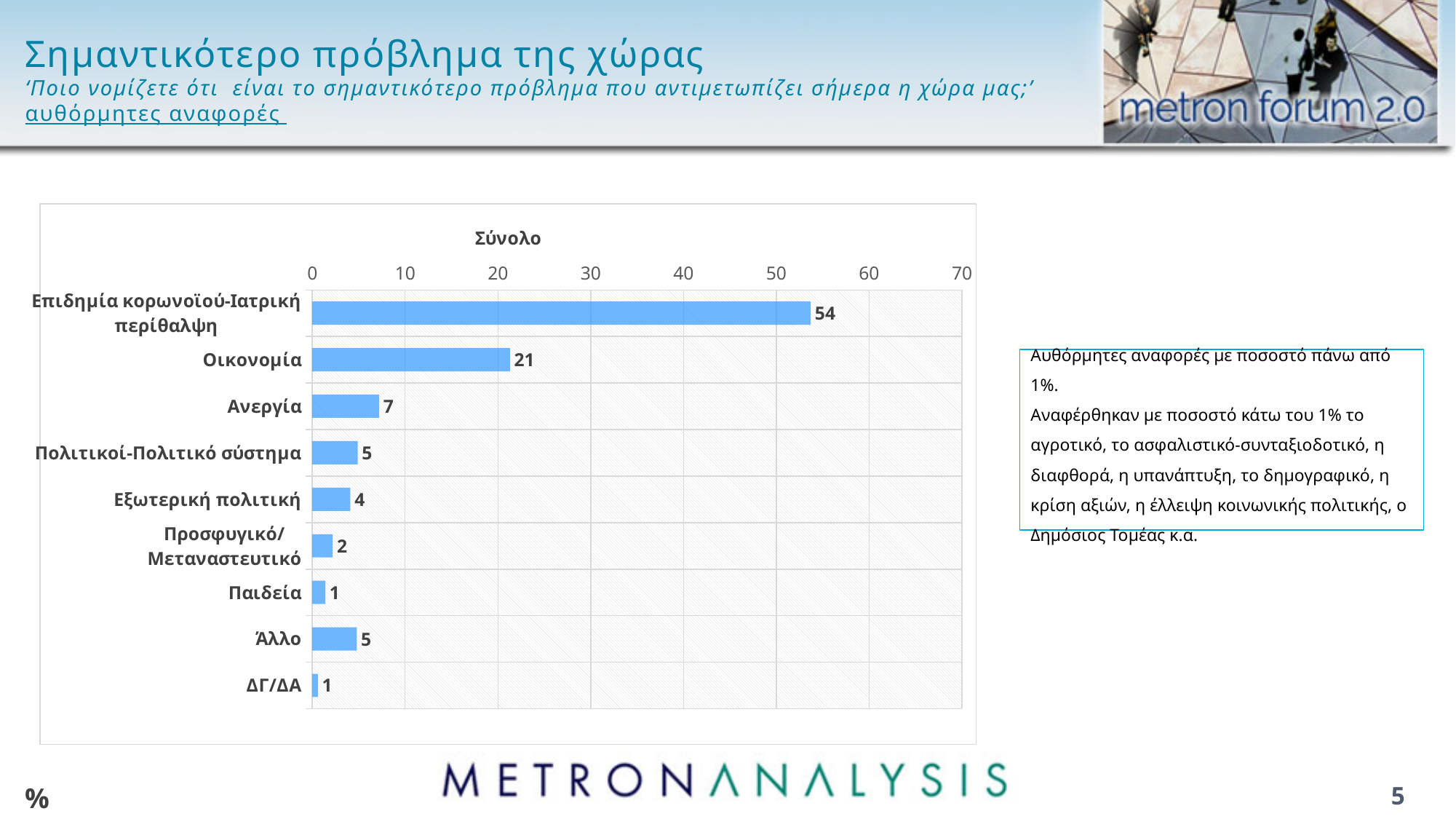
What value is shown for Ανεργία? 7 What is the difference between the values for Ανεργία and Πολιτικοί-Πολιτικό σύστημα? 2 What kind of chart is shown on the slide? Bar chart Is the value for Επιδημία κορωνοϊού-Ιατρική περίθαλψη greater or less than 50? greater How many categories are shown in the chart? 9 What value is shown for Οικονομία? 21 Which is larger, the value for Ανεργία or the value for Άλλο? Ανεργία What value is shown for Εξωτερική πολιτική? 4 Which category has the highest value? Επιδημία κορωνοϊού-Ιατρική περίθαλψη What is the difference between the values for Επιδημία κορωνοϊού-Ιατρική περίθαλψη and Οικονομία? 33 What is the title shown above the chart? Σύνολο What value is shown for Προσφυγικό/Μεταναστευτικό? 2